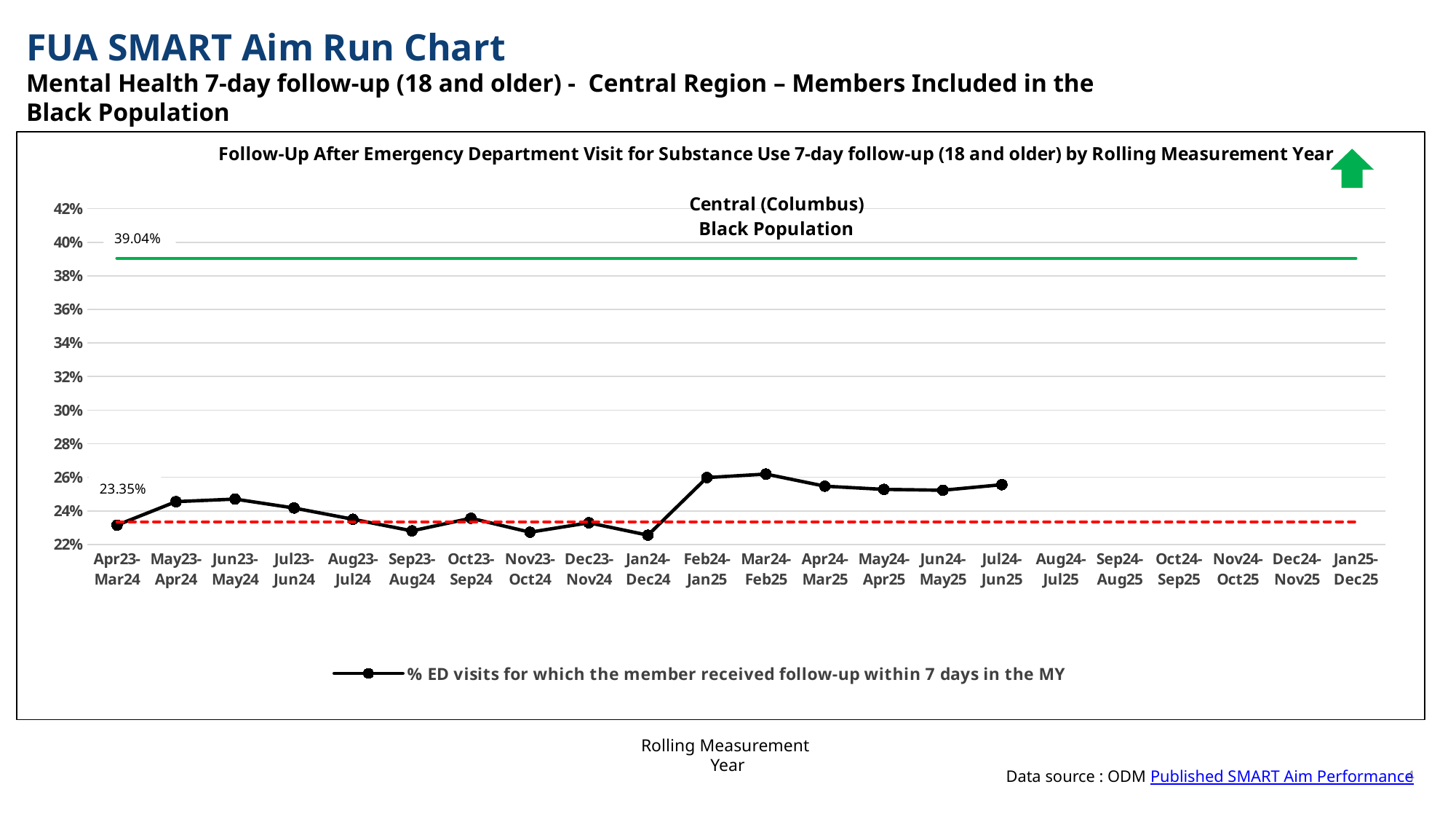
Does the line rise or fall from Jan24-Dec24 to Feb24-Jan25? Rise Which is larger, the value for Feb24-Jan25 or the value for Sep23-Aug24? Feb24-Jan25 What kind of chart is shown on the slide? Line chart What value is labelled on the green target line? 39.04% What is the legend entry for the plotted line? % ED visits for which the member received follow-up within 7 days in the MY Is the value for Sep23-Aug24 greater or less than 24%? less How many rolling measurement year periods have a plotted data point on the line? 16 How many series does the legend list? 1 What value is labelled on the red dashed baseline? 23.35% Is the value for Jul24-Jun25 greater or less than 24%? greater Is the value for Feb24-Jan25 greater or less than 24%? greater Which is larger, the value for Jun23-May24 or the value for Nov23-Oct24? Jun23-May24